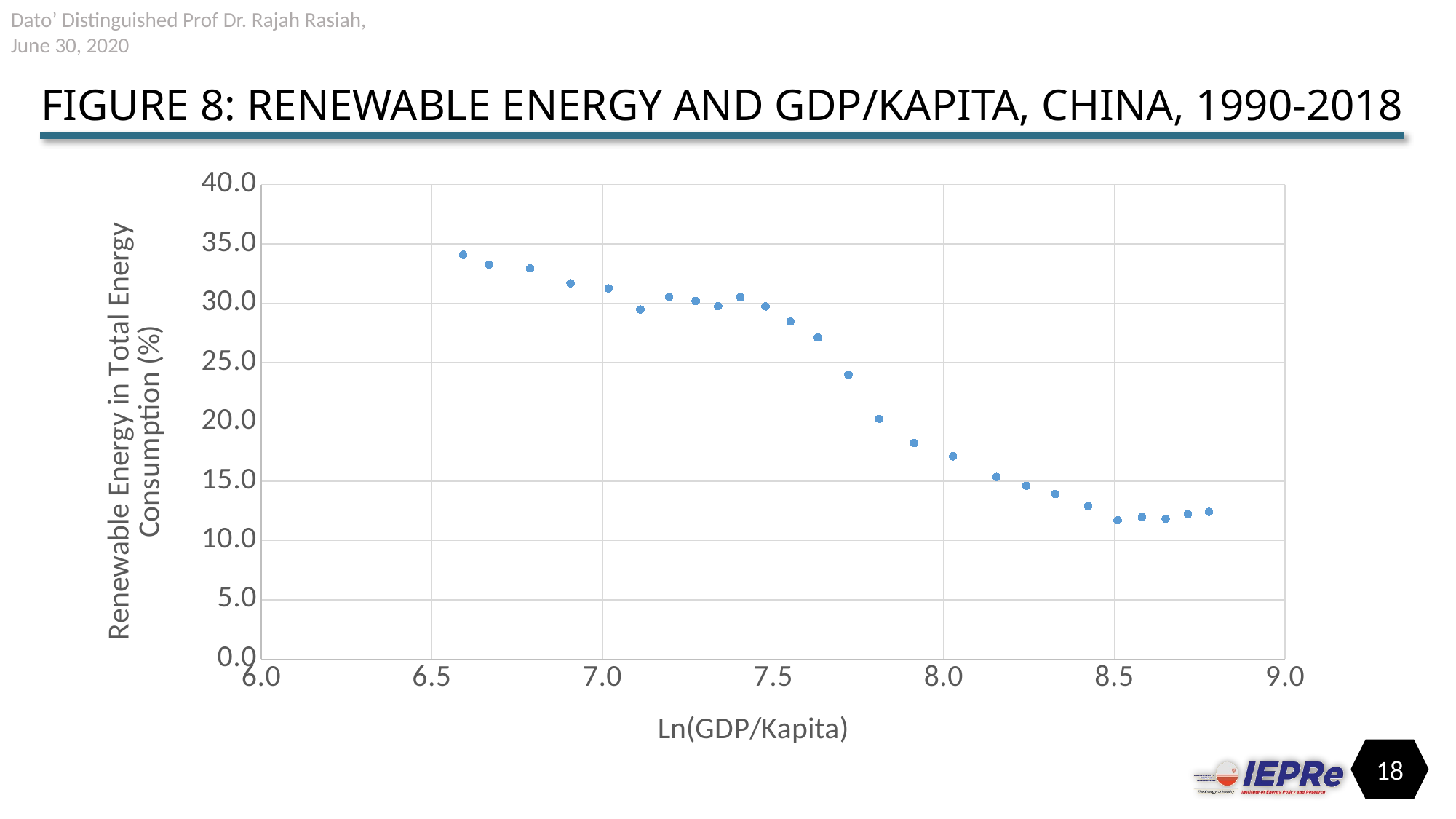
What is the label of the y axis? Renewable Energy in Total Energy Consumption (%) What kind of chart is shown on the slide? scatter chart Is the renewable energy share for the point at Ln(GDP/Kapita) of about 7.0 greater or less than 30.0? greater Do the points with the highest renewable energy share lie at the low or the high end of the Ln(GDP/Kapita) axis? low end Which has the larger renewable energy share: the point at Ln(GDP/Kapita) of about 7.0 or the point at about 8.0? the point at about 7.0 Is the renewable energy share for the point at Ln(GDP/Kapita) of about 8.0 greater or less than 20.0? less Is the renewable energy share for the rightmost point (Ln(GDP/Kapita) near 8.8) greater or less than 15.0? less What is the label of the x axis? Ln(GDP/Kapita) As Ln(GDP/Kapita) increases along the x axis, do the renewable energy values generally rise or fall? fall